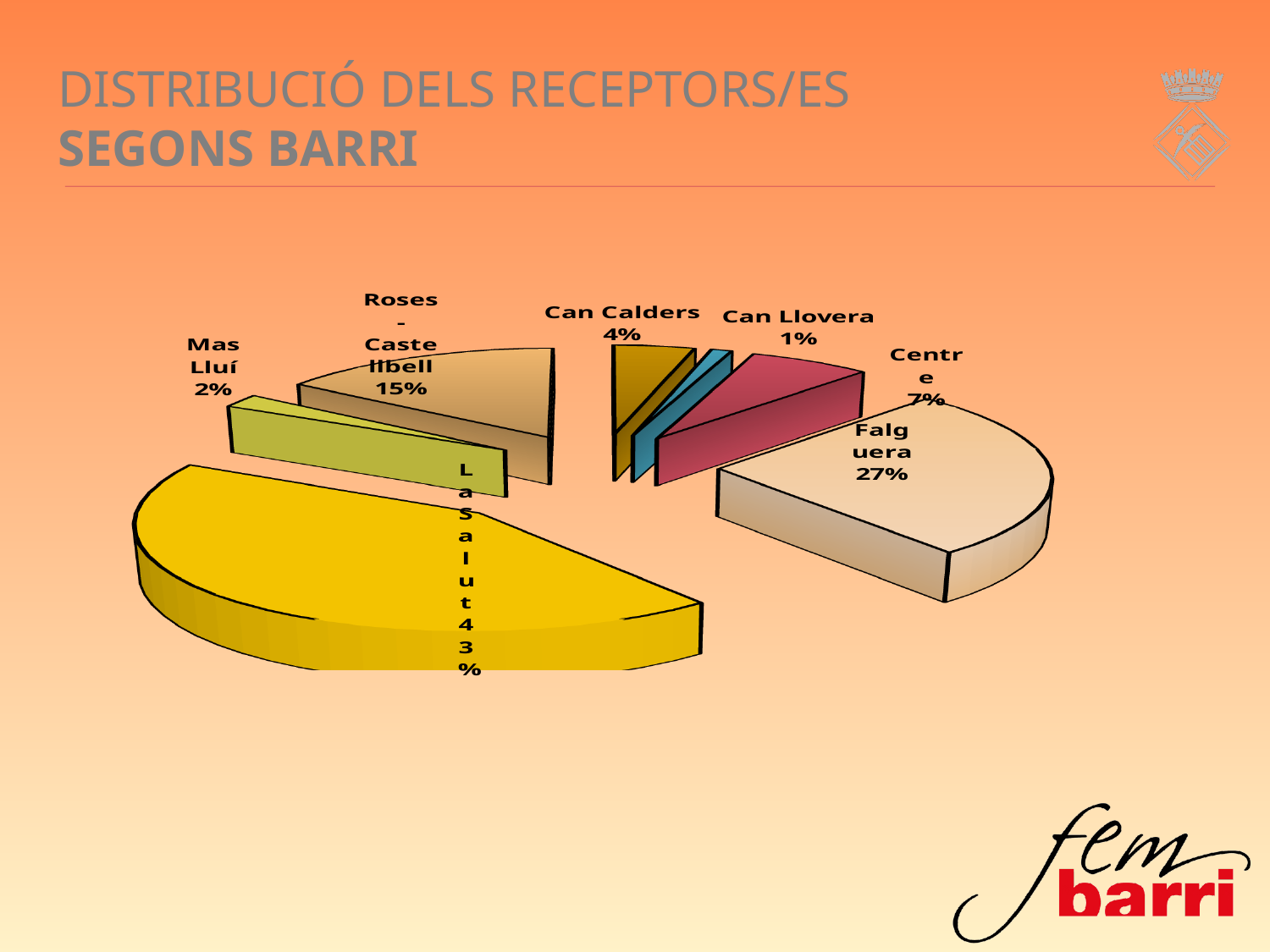
Which neighbourhood has the smallest slice of the pie? Can Llovera What is the value shown for Can Calders? 4% What kind of chart is shown on the slide? Pie chart What share of the pie does Falguera have? 27% How many slices does the pie chart have? 7 What is the value shown for Roses - Castellbell? 15% Which is larger, the share for Mas Lluí or the share for Centre? Centre What is the difference in percentage points between La Salut and Falguera? 16 What is the title of the slide containing the chart? DISTRIBUCIÓ DELS RECEPTORS/ES SEGONS BARRI Which neighbourhood has the largest slice of the pie? La Salut What is the value shown for Centre? 7% What share of the pie does La Salut have? 43%